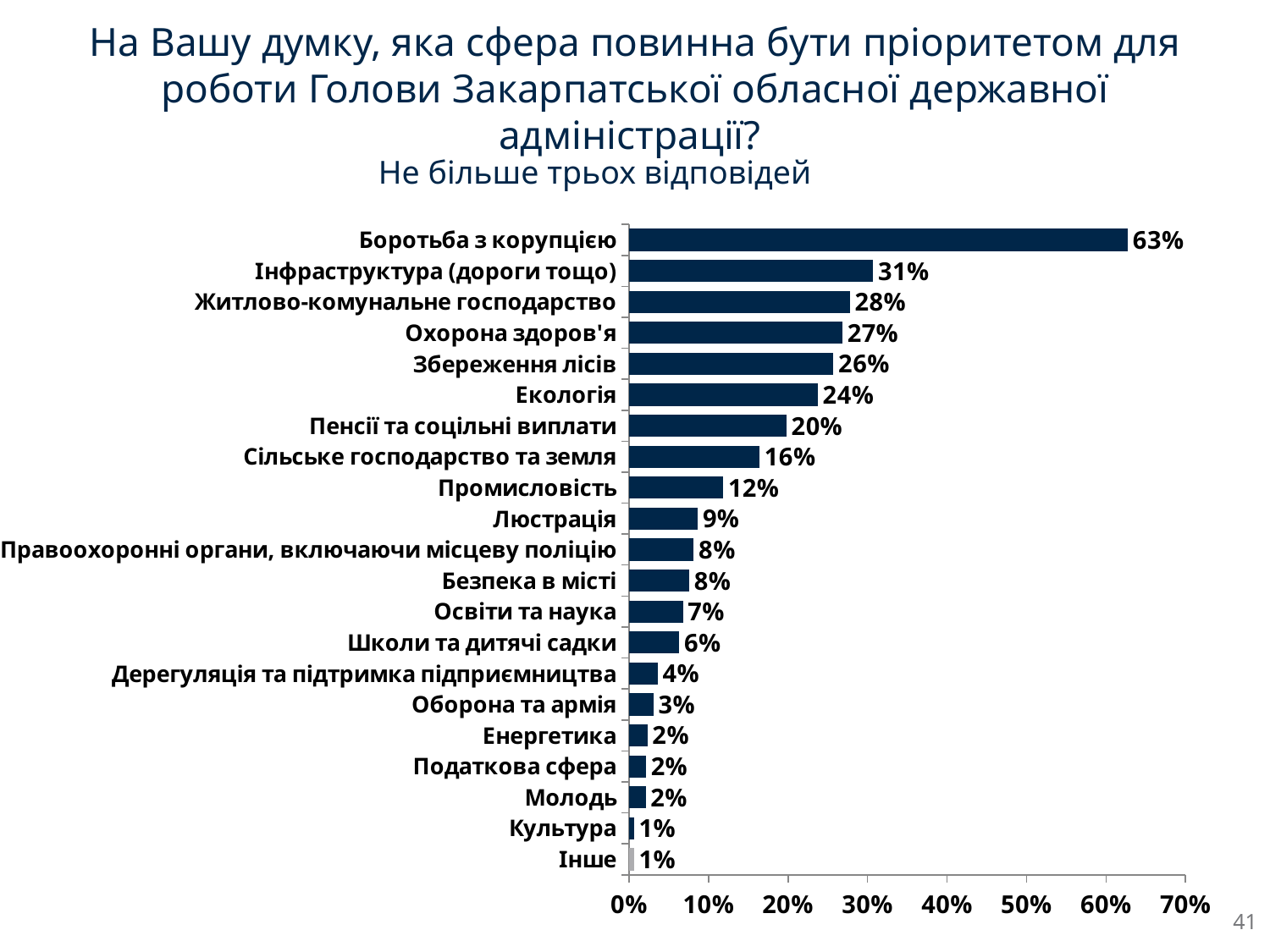
What is the difference between the values for "Охорона здоров'я" and "Промисловість"? 15% What percentage of respondents chose "Боротьба з корупцією"? 63% How many categories are shown in the chart? 21 Which is larger, the value for "Збереження лісів" or the value for "Сільське господарство та земля"? Збереження лісів What is the value shown for "Пенсії та соціальні виплати"? 20% Which category has the highest value? Боротьба з корупцією What kind of chart is shown on the slide? bar chart Is the value for "Житлово-комунальне господарство" greater or less than 20%? greater What is the highest value shown on the horizontal axis? 70% What is the value shown for "Екологія"? 24% Is the value for "Люстрація" greater or less than 10%? less What is the difference between the values for "Боротьба з корупцією" and "Інфраструктура (дороги тощо)"? 32%